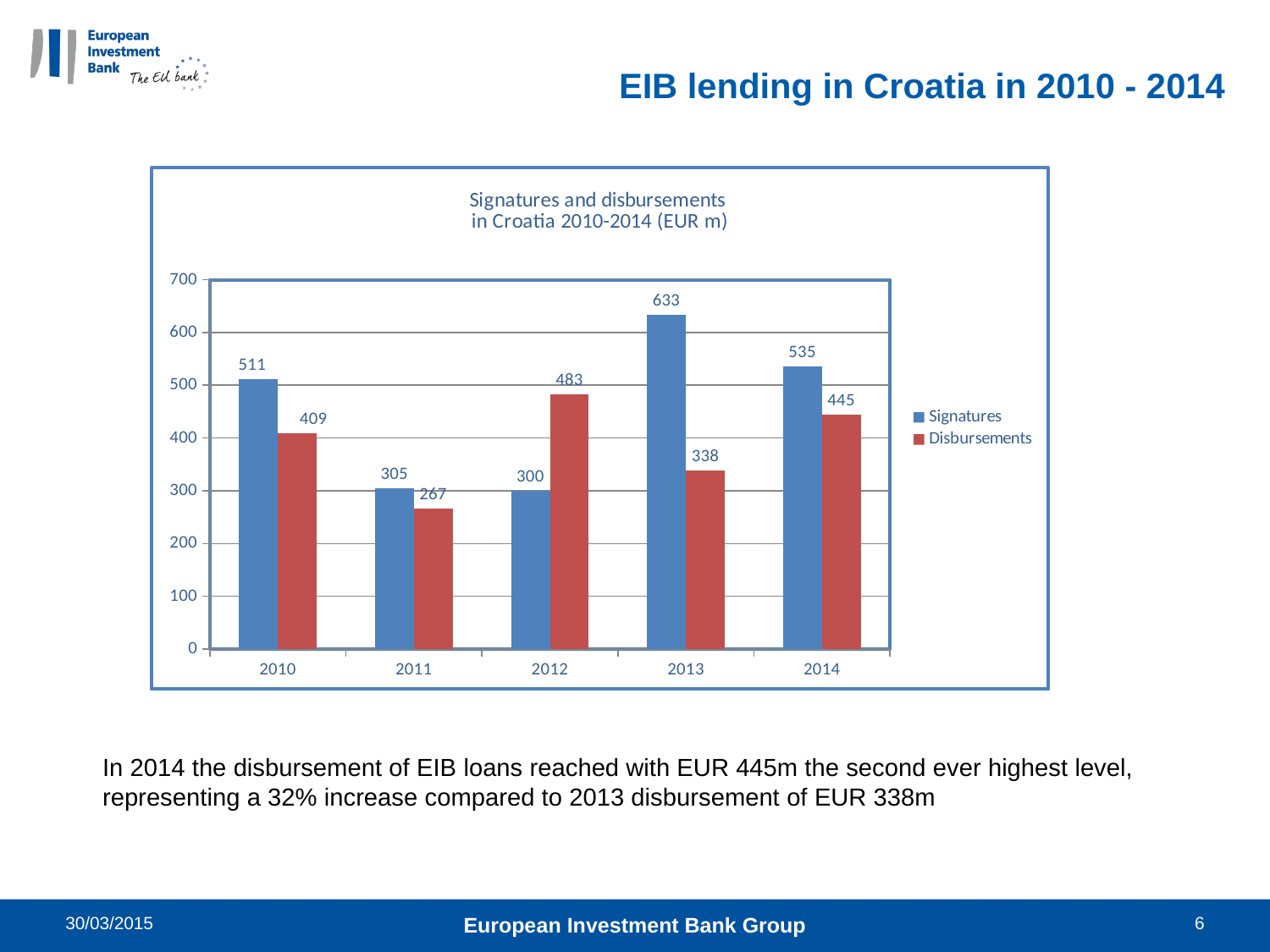
What colour represents Disbursements in the chart? Red In which year were Disbursements lowest? 2011 What was the value of Disbursements in 2011? 267 Which was larger in 2012, Signatures or Disbursements? Disbursements What was the value of Signatures in 2013? 633 What kind of chart is shown on the slide? Bar chart What is the title of the chart? Signatures and disbursements in Croatia 2010-2014 (EUR m) How many years are shown on the x axis? 5 How many series does the legend list? 2 Did Disbursements rise or fall from 2013 to 2014? Rise What is the difference between Signatures and Disbursements in 2014? 90 In which year were Signatures highest? 2013